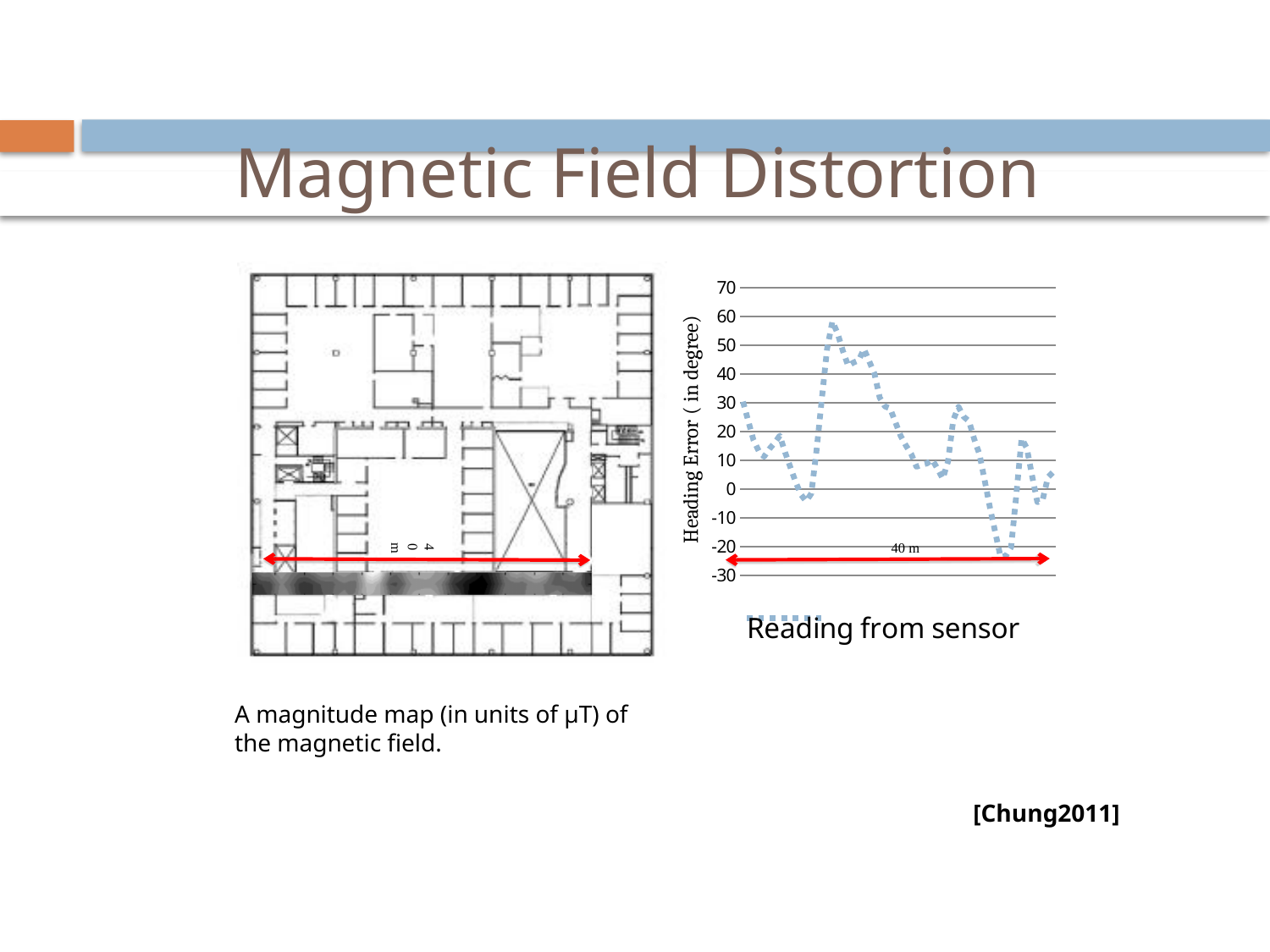
What distance does the red arrow beneath the chart span? 40 m How many series does the legend of the chart list? 1 Is the value at the end of the line higher or lower than the value at the start of the line? lower What kind of chart is shown on the right of the slide? line chart Is the value at the end of the line in the chart greater or less than 20? less Is the lowest value reached by the line in the chart greater or less than -10? less What is the legend entry for the series in the chart? Reading from sensor Is the value at the start of the line in the chart greater or less than 20? greater What is the label of the vertical axis of the chart? Heading Error ( in degree)